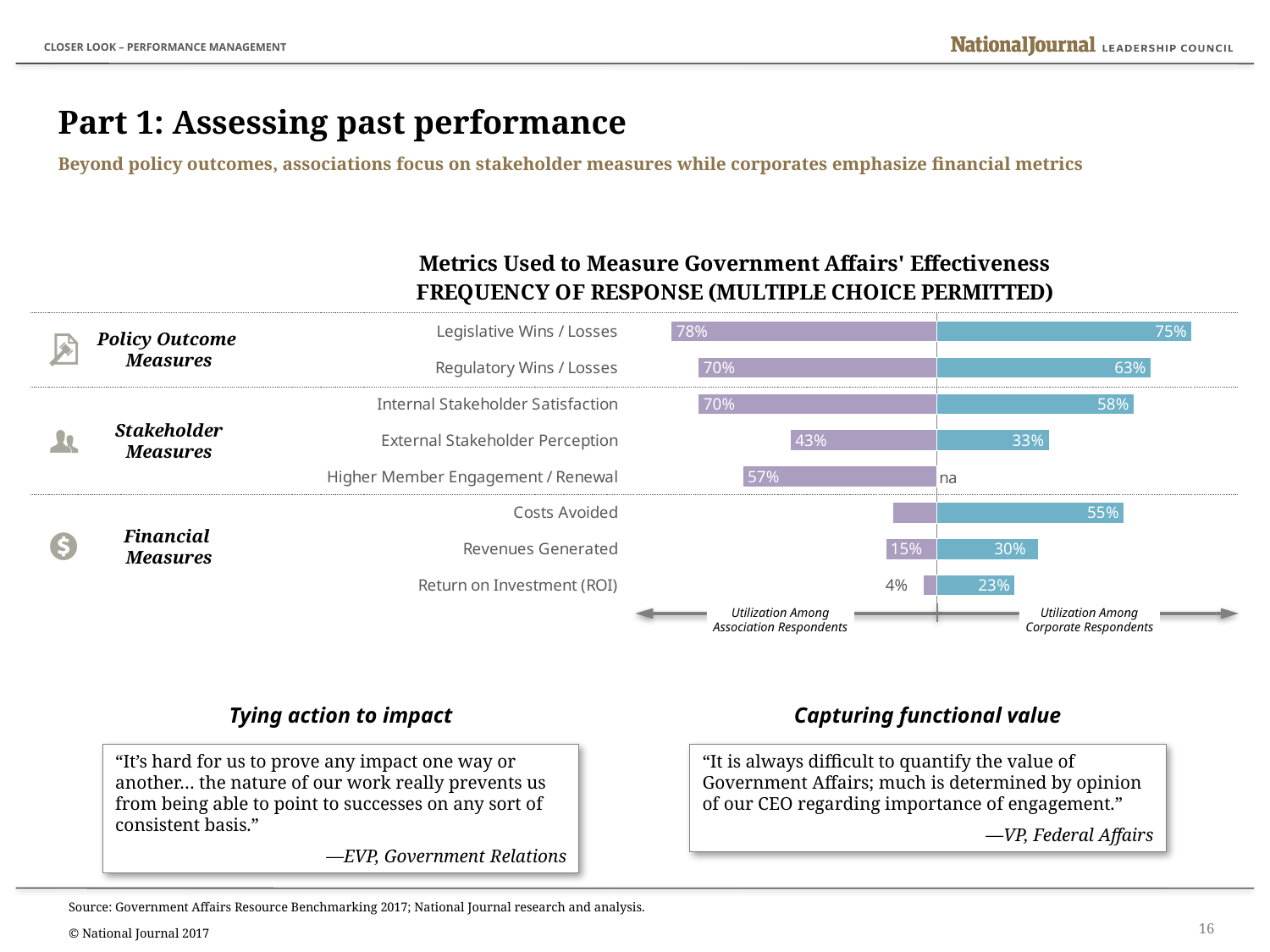
Which metric has the lowest utilization among association respondents? Return on Investment (ROI) How many metrics are listed in the chart? 8 What is shown for Higher Member Engagement / Renewal among corporate respondents? na What is the difference between association and corporate respondents for External Stakeholder Perception? 10% For Revenues Generated, which group has the larger value: association or corporate respondents? Corporate respondents How many respondent groups does the chart compare? 2 Which metric has the highest utilization among corporate respondents? Legislative Wins / Losses What percentage of corporate respondents use Costs Avoided as a metric? 55% What type of chart is used to show the metrics? Bar chart Which respondent group is shown on the left side of the chart? Association Respondents What percentage of association respondents use Legislative Wins / Losses as a metric? 78% What is the value for Return on Investment (ROI) among association respondents? 4%